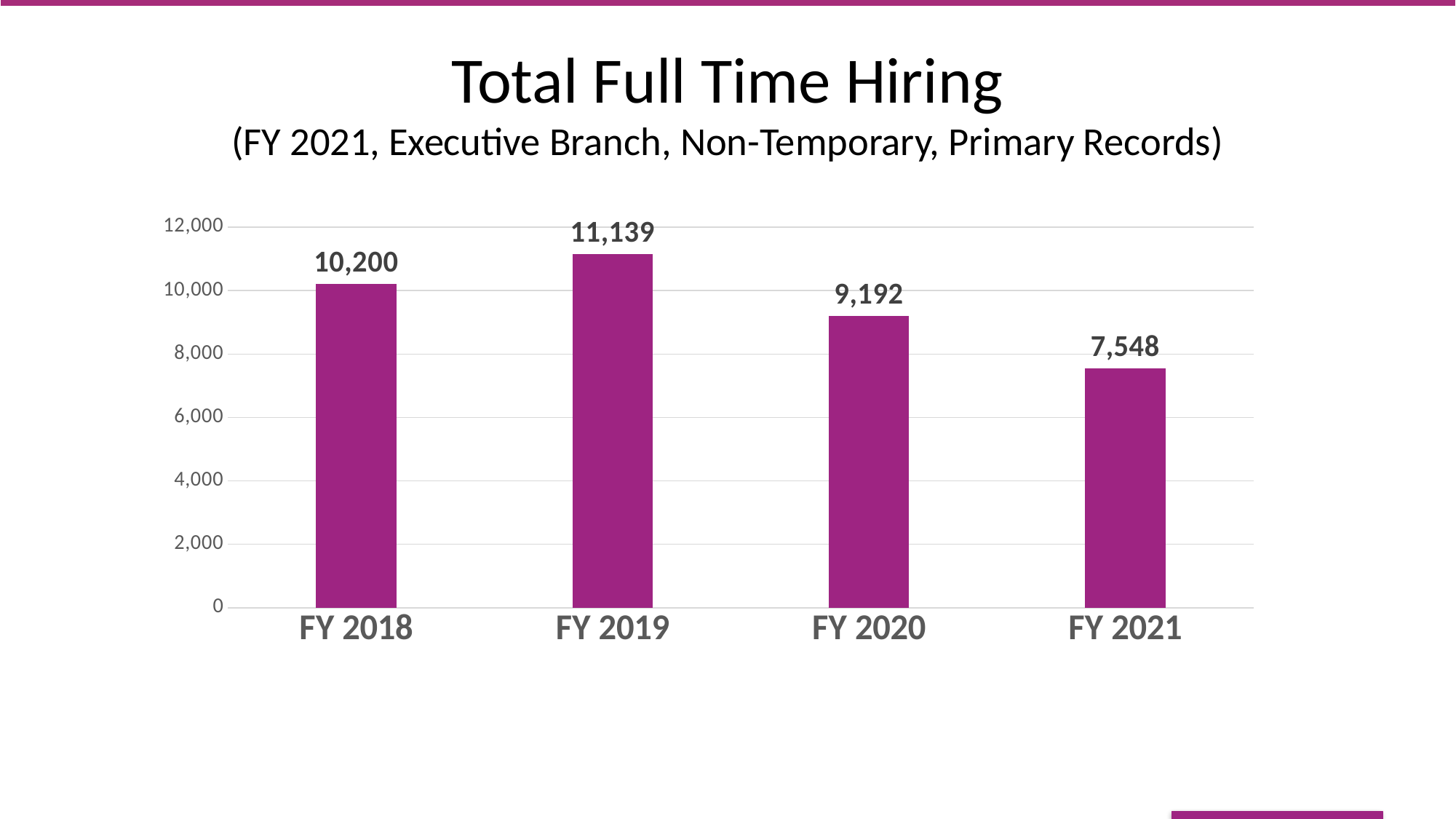
What is the total full time hiring value for FY 2019? 11,139 What is the difference in total full time hiring between FY 2019 and FY 2021? 3,591 Which fiscal year has the lowest total full time hiring? FY 2021 How many fiscal years are shown in the chart? 4 What kind of chart is shown on the slide? Bar chart Which fiscal year has the highest total full time hiring? FY 2019 What is the total full time hiring value for FY 2021? 7,548 What is the difference in total full time hiring between FY 2018 and FY 2020? 1,008 From FY 2019 to FY 2021, do the total full time hiring values rise or fall? Fall What is the total full time hiring value for FY 2020? 9,192 Which has a larger total full time hiring value, FY 2018 or FY 2020? FY 2018 What is the total full time hiring value for FY 2018? 10,200